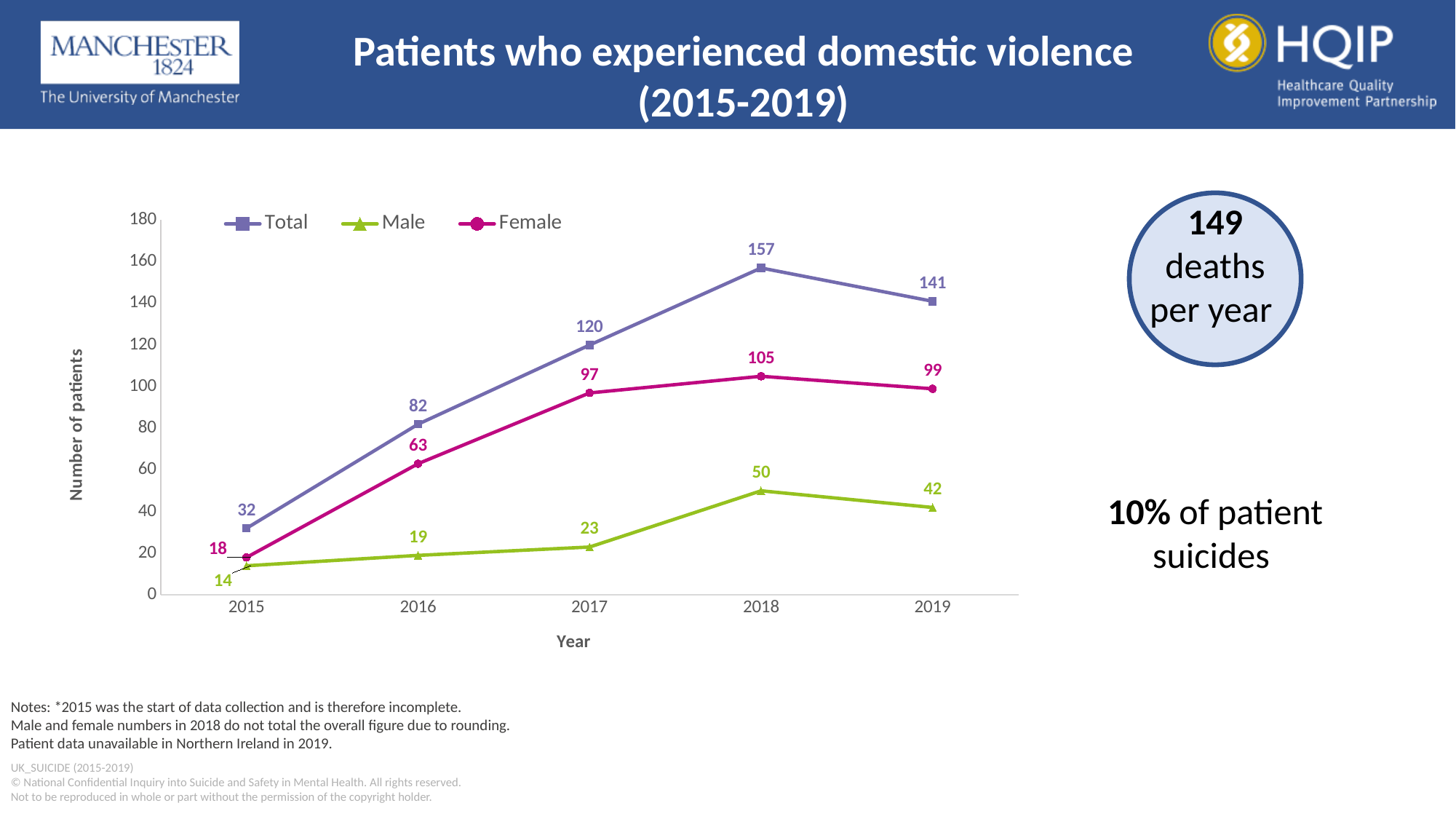
Does the Female series rise or fall from 2015 to 2018? Rise What kind of chart is shown on the slide? Line chart In which year is the Total series highest? 2018 What is the Female value for 2016? 63 How many series does the legend list? 3 What is the Male value for 2019? 42 What is the difference between the Female and Male values in 2017? 74 In which year is the Male series lowest? 2015 Is the Total value for 2017 greater or less than 100? greater What is the Total value for 2018? 157 Which is larger in 2019, the Female value or the Male value? Female How many years are plotted on the x axis? 5